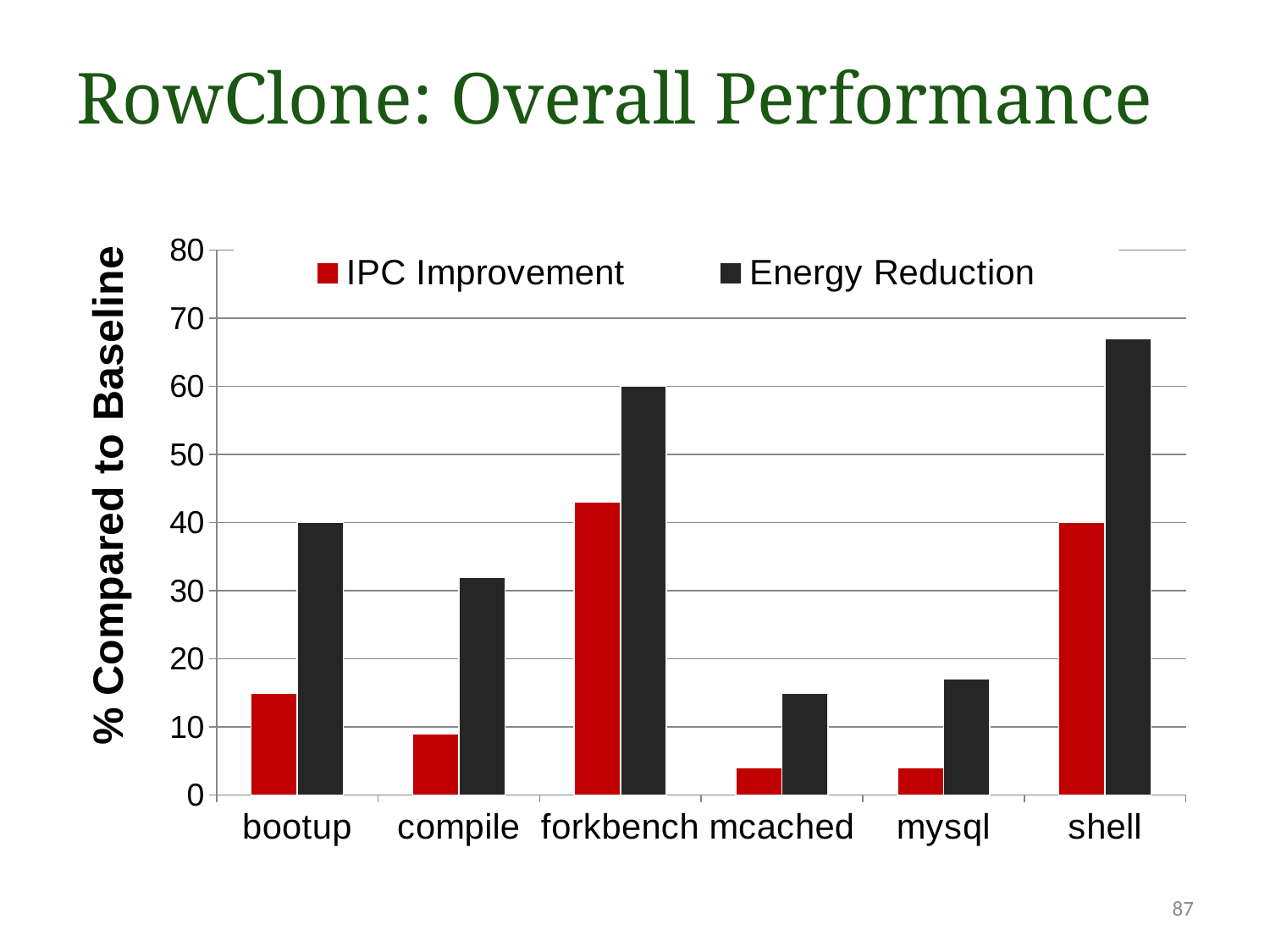
Which category has the highest IPC Improvement? forkbench Which is larger, the Energy Reduction for forkbench or for shell? shell How many categories are shown on the x axis? 6 Is the Energy Reduction for compile greater or less than 30? greater What kind of chart is shown on the slide? bar chart Is the Energy Reduction for mysql greater or less than 20? less Which category has the highest Energy Reduction? shell How many series does the legend list? 2 Is the IPC Improvement for forkbench greater or less than 40? greater Which is larger, the IPC Improvement for bootup or for compile? bootup What is the label of the y axis? % Compared to Baseline